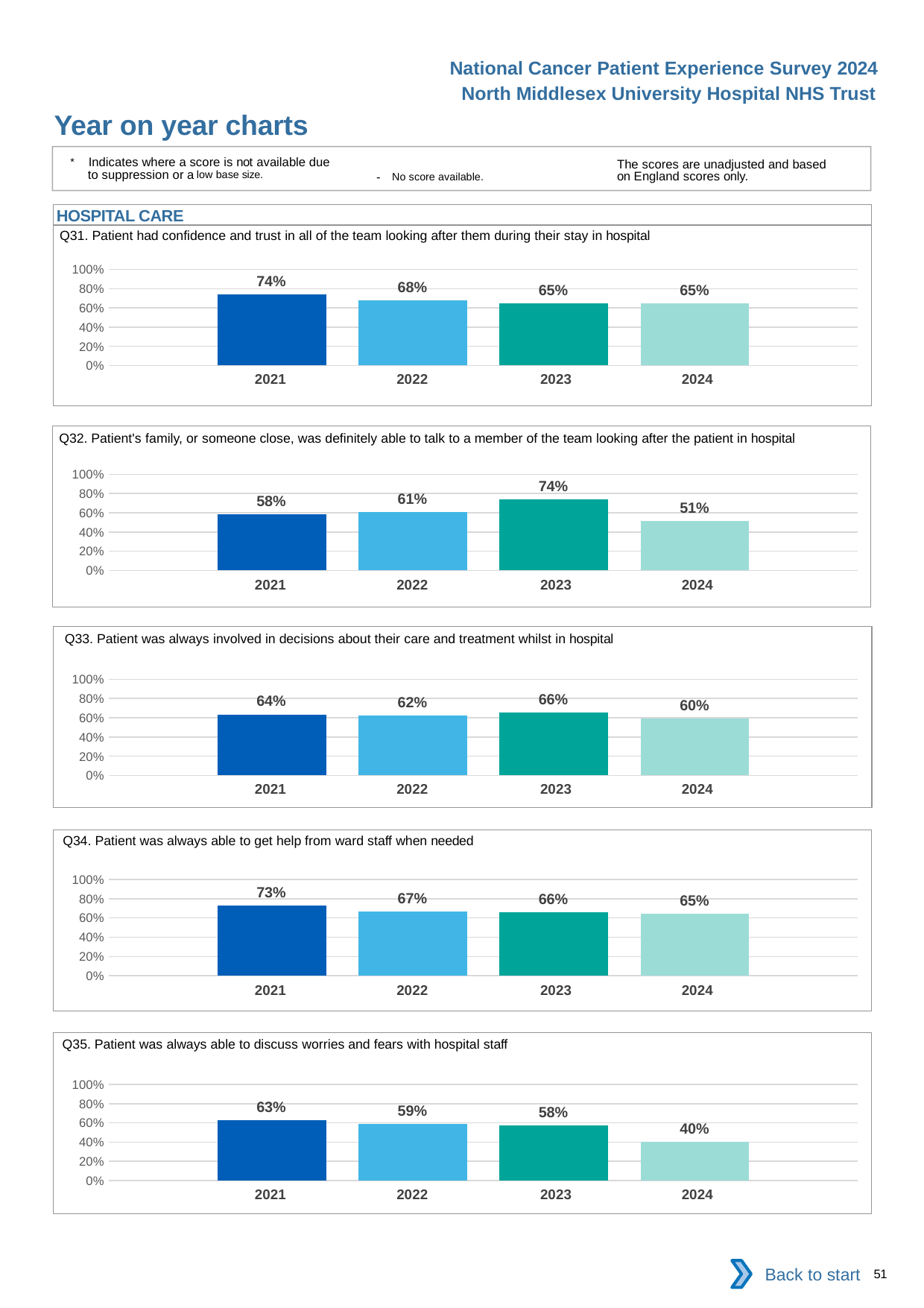
How many years are shown in the Q31 chart? 4 In the Q32 chart, what is the difference between the 2023 value and the 2022 value? 13% What kind of chart is the Q33 chart? bar chart In the Q35 chart, what is the difference between the 2021 value and the 2024 value? 23% What is the section heading above the Q31 chart? HOSPITAL CARE In the Q32 chart, which year has the highest value? 2023 In the Q35 chart, what is the value for 2024? 40% In the Q32 chart, which year has the lowest value? 2024 In the Q33 chart, which is larger, the value for 2023 or the value for 2024? 2023 In the Q34 chart, do the values rise or fall from 2021 to 2024? fall In the Q34 chart, is the value for 2021 greater or less than 60%? greater In the Q31 chart, what is the value for 2021? 74%